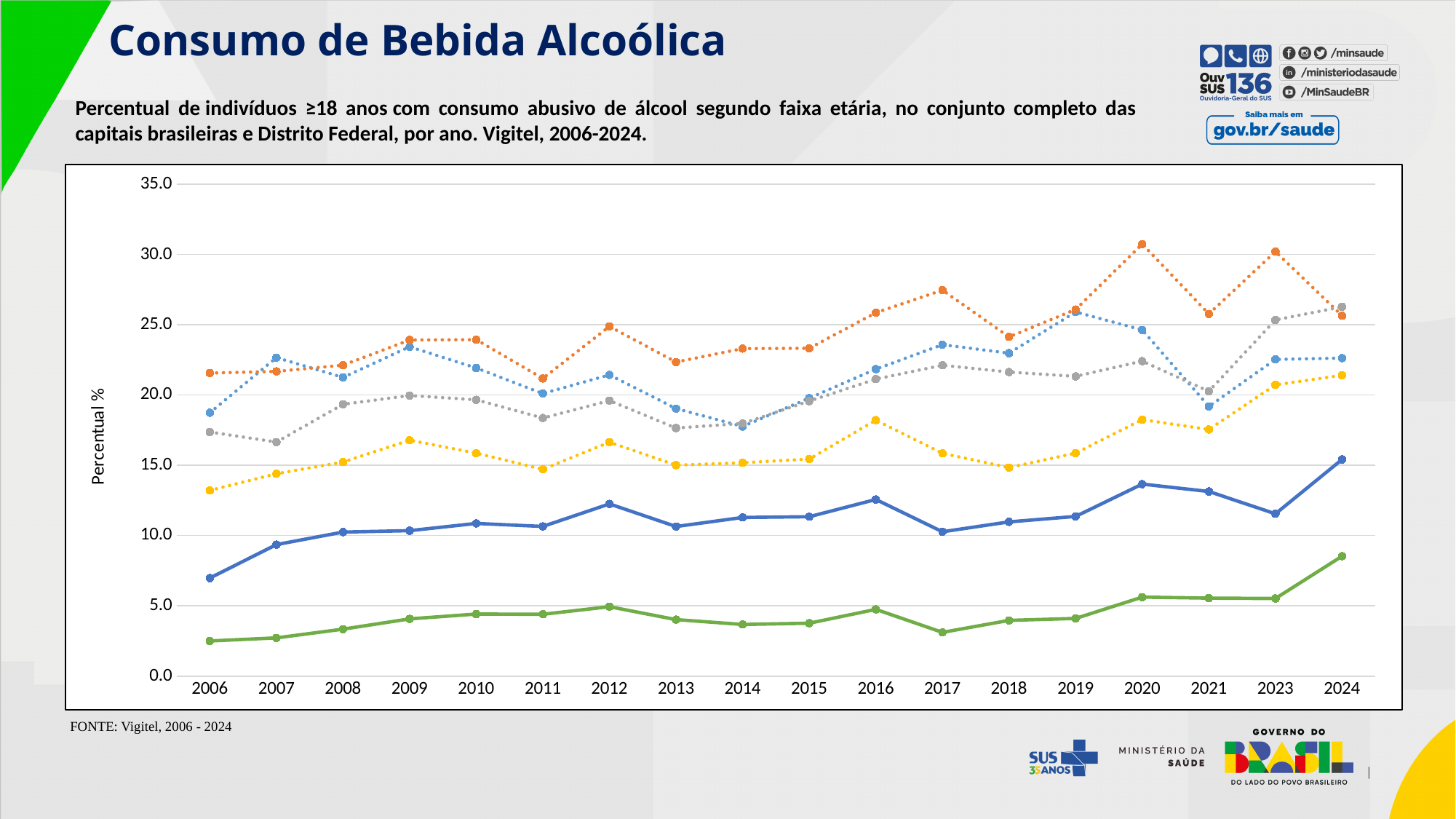
Is the value of the solid green line in 2024 greater or less than 5.0? greater How many years are shown on the x axis of the chart? 18 In which year does the solid blue line reach its highest value? 2024 What kind of chart is shown on the slide? Line chart Is the value of the yellow dotted line in 2006 greater or less than 15.0? less Is the value of the solid blue line in 2006 greater or less than 10.0? less What is the label of the y axis? Percentual % How many lines are plotted on the chart? 6 In 2024, which is higher: the orange dotted line or the solid green line? Orange dotted line In which year does the solid blue line have its lowest value? 2006